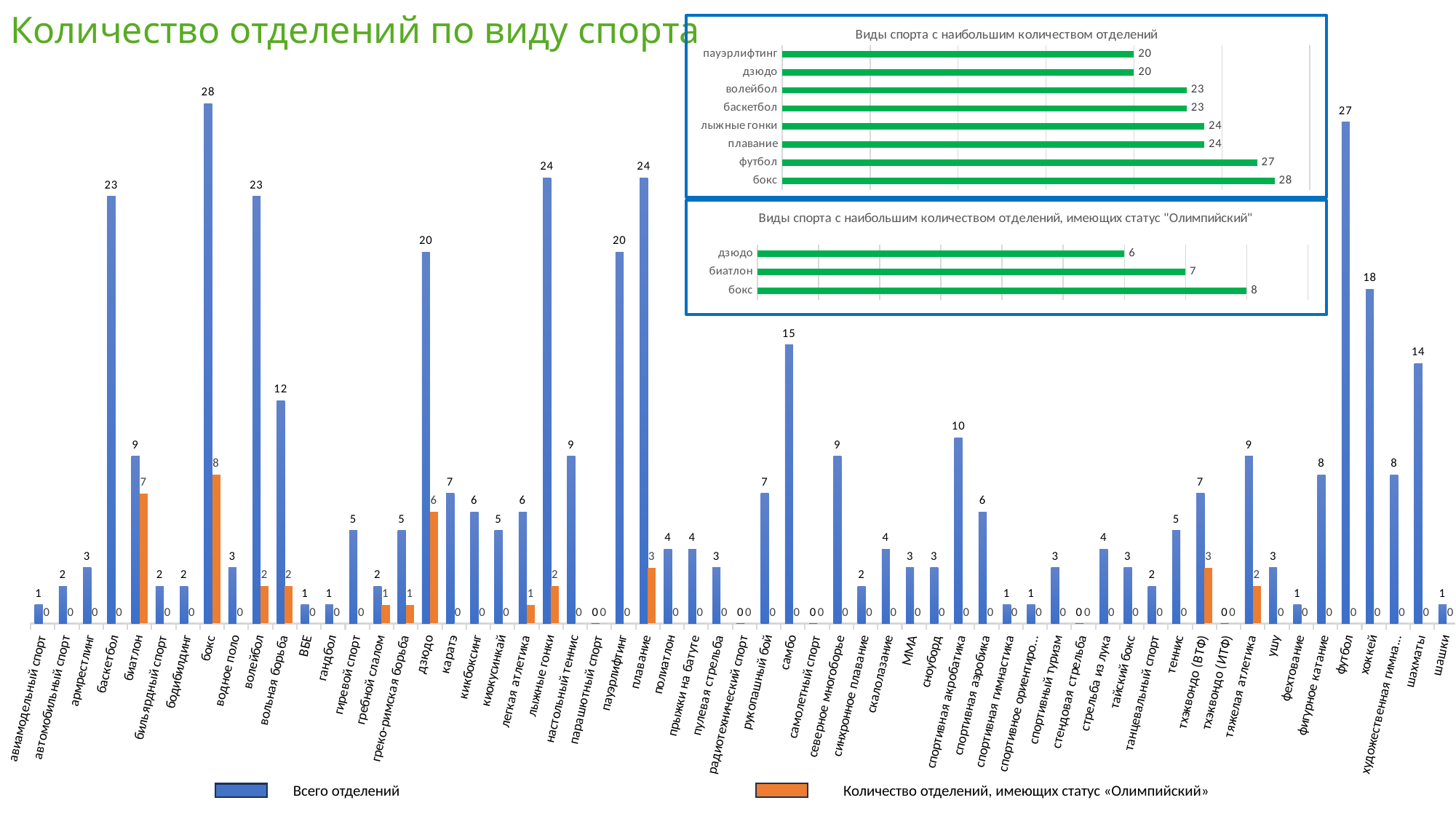
How many sports are shown in the inset chart 'Виды спорта с наибольшим количеством отделений, имеющих статус "Олимпийский"'? 3 In the main chart 'Количество отделений по виду спорта', which sport has the highest value of 'Всего отделений'? бокс In the inset chart 'Виды спорта с наибольшим количеством отделений', what is the value for лыжные гонки? 24 In the inset chart 'Виды спорта с наибольшим количеством отделений, имеющих статус "Олимпийский"', which sport has the lowest value? дзюдо What kind of chart is the inset chart 'Виды спорта с наибольшим количеством отделений'? bar chart In the main chart 'Количество отделений по виду спорта', what is the difference between the 'Всего отделений' values for бокс and футбол? 1 In the main chart 'Количество отделений по виду спорта', how many departments with 'Олимпийский' status does биатлон have? 7 In the main chart 'Количество отделений по виду спорта', which has a larger 'Всего отделений' value, хоккей or самбо? хоккей In the main chart 'Количество отделений по виду спорта', how many departments with 'Олимпийский' status does плавание have? 3 How many series does the legend of the main chart 'Количество отделений по виду спорта' list? 2 How many sports are shown in the inset chart 'Виды спорта с наибольшим количеством отделений'? 8 In the main chart 'Количество отделений по виду спорта', what is the value of 'Всего отделений' for бокс? 28